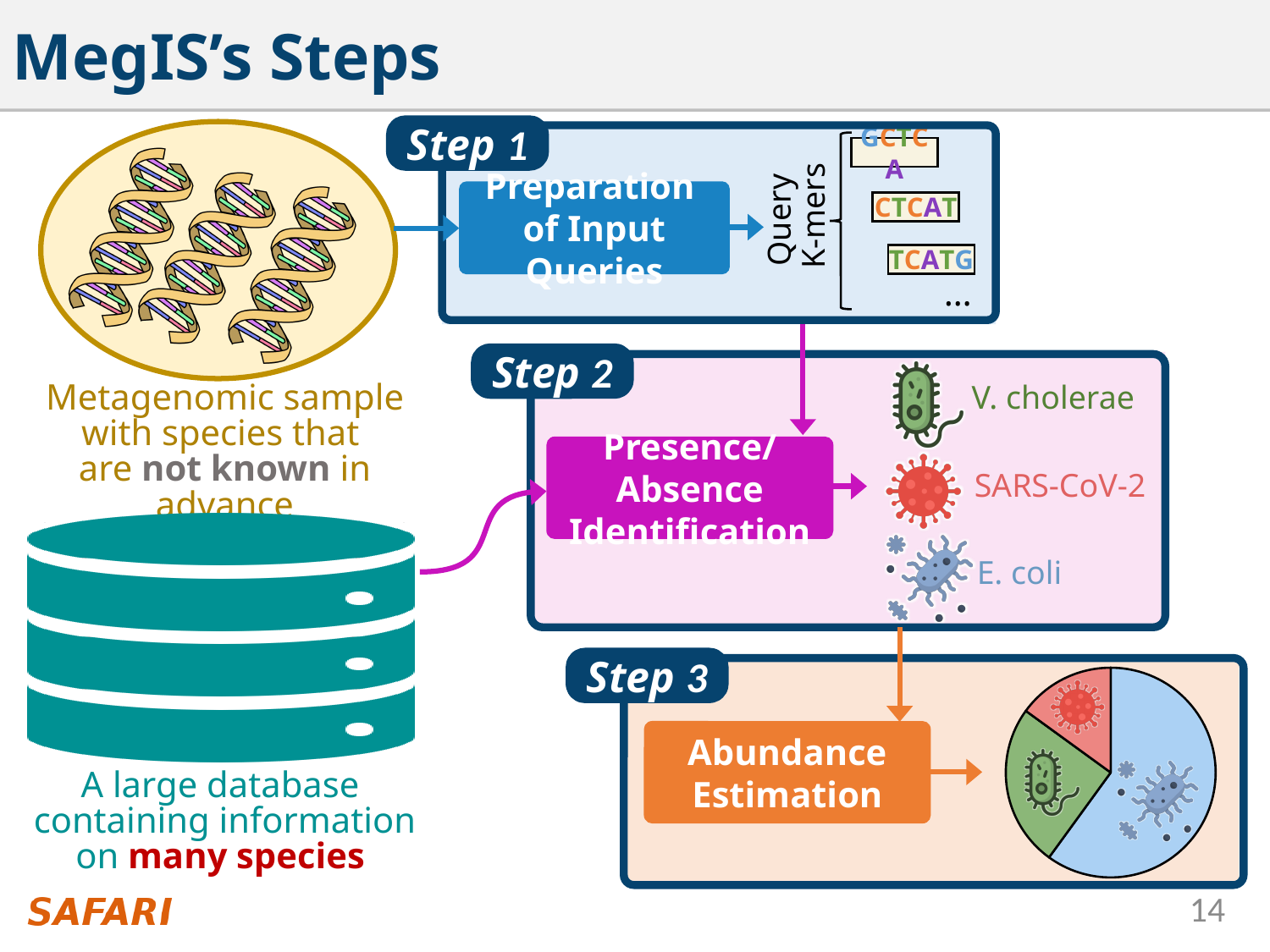
What is the label of the box that points to the pie chart in Step 3? Abundance Estimation In the pie chart in the Step 3 box, is the blue slice larger or smaller than the red slice? larger What kind of chart is shown in the Step 3 box? pie chart How many slices does the pie chart in the Step 3 box have? 3 In the pie chart in the Step 3 box, is the blue slice larger or smaller than the green slice? larger Which slice of the pie chart in the Step 3 box is the largest? the blue slice Which step's box contains the pie chart on the slide? Step 3